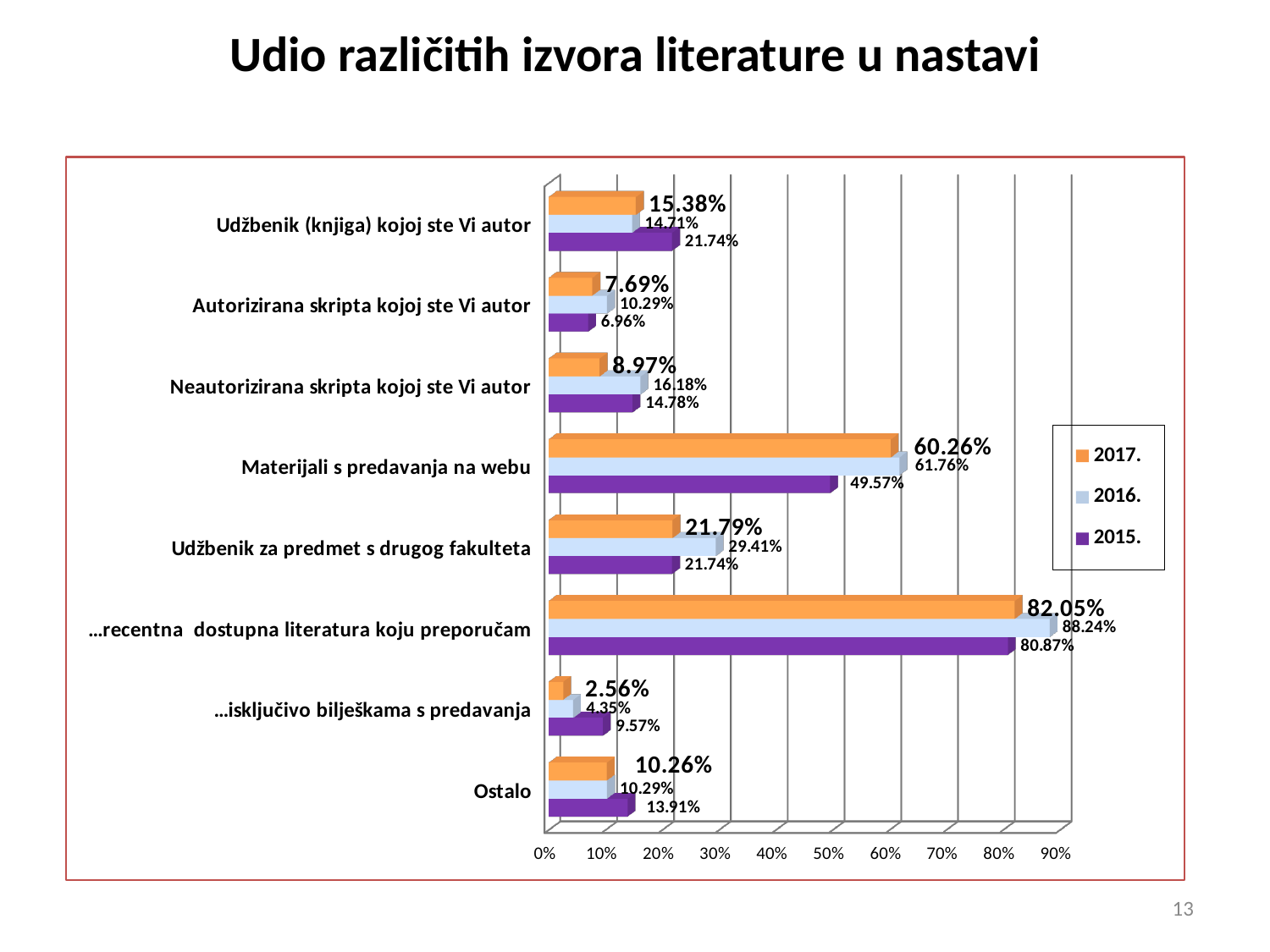
What kind of chart is shown on the slide? Bar chart What is the title of the chart? Udio različitih izvora literature u nastavi What is the 2016. value for "Udžbenik za predmet s drugog fakulteta"? 29.41% What is the difference between the 2016. and 2015. values for "...recentna dostupna literatura koju preporučam"? 7.37% What is the 2015. value for "...isključivo bilješkama s predavanja"? 9.57% Is the 2015. value for "Materijali s predavanja na webu" greater or less than 50%? less How many series does the legend list? 3 How many categories are shown on the chart? 8 What is the 2017. value for "Materijali s predavanja na webu"? 60.26% For "Neautorizirana skripta kojoj ste Vi autor", which is larger: the 2016. value or the 2017. value? 2016. Which category has the highest 2017. value? ...recentna dostupna literatura koju preporučam Which category has the lowest 2017. value? ...isključivo bilješkama s predavanja